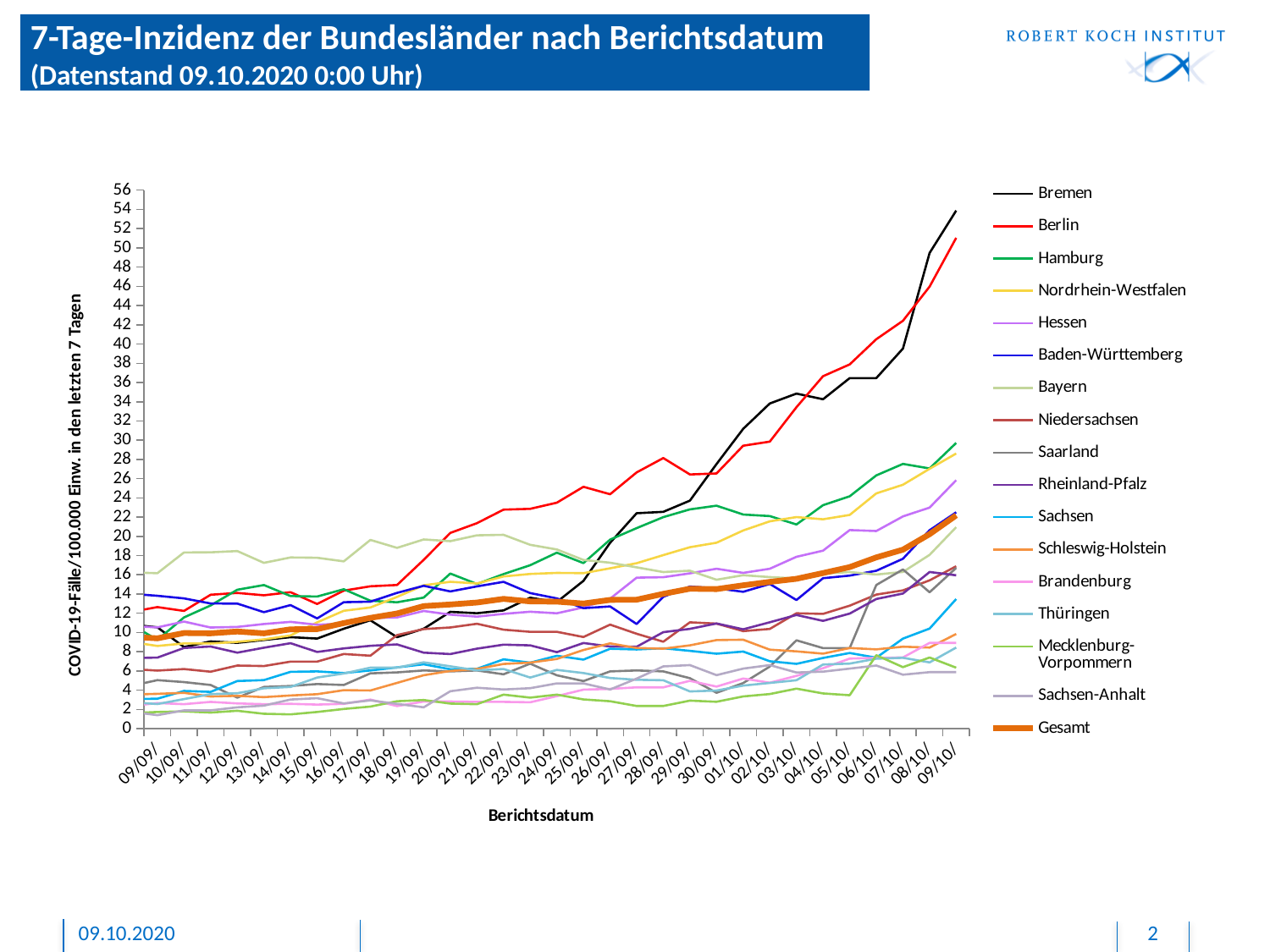
Is the value for Bayern on 09/09 greater or less than 14? greater What kind of chart is shown on the slide? line chart On 09/10, which is higher: Bremen or Hamburg? Bremen Does the Gesamt line rise or fall from 09/09 to 09/10? rises Is the value for Mecklenburg-Vorpommern on 09/09 greater or less than 4? less How many series does the legend list? 17 Which series has the highest value on 09/10? Bremen How many dates are shown along the x axis? 31 What is the label of the x axis? Berichtsdatum Is the value for Gesamt on 09/10 greater or less than 20? greater Which series is drawn with the thickest line? Gesamt